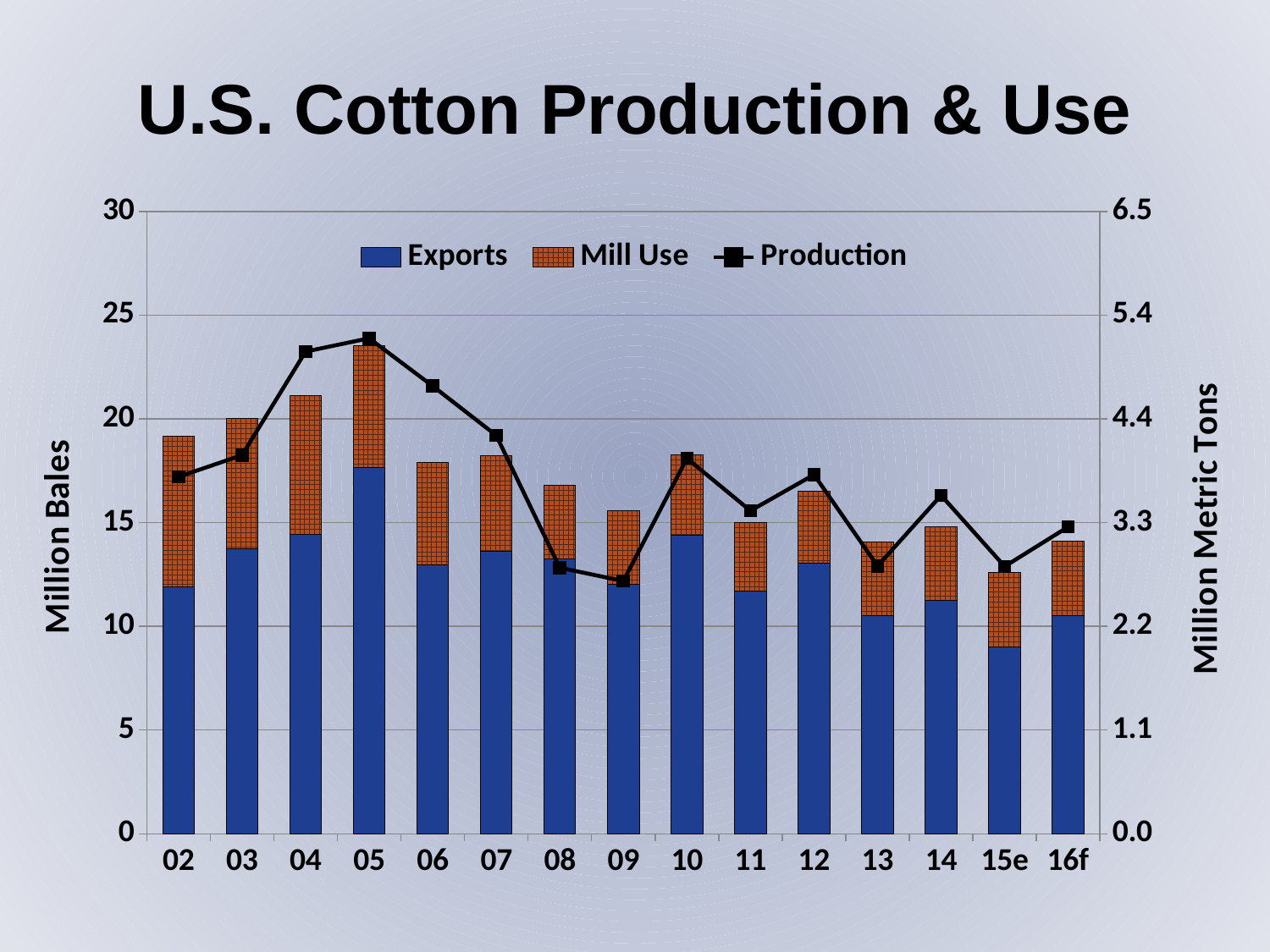
How many years are shown along the x axis? 15 What kind of chart is shown on the slide? Stacked bar chart with a line Which year has the larger total stacked bar, 09 or 10? 10 In which year is the total stacked bar (Exports plus Mill Use) the tallest? 05 In which year does the Production line reach its lowest point? 09 Is the Exports value for 05 greater or less than 15 million bales? greater Does the Production line rise or fall from 05 to 09? Fall Is the Production value for 09 greater or less than 3.3 million metric tons? less How many series does the legend list? 3 In which year is the total stacked bar (Exports plus Mill Use) the shortest? 15e Is the Exports value for 15e greater or less than 10 million bales? less In which year does the Production line reach its highest point? 05